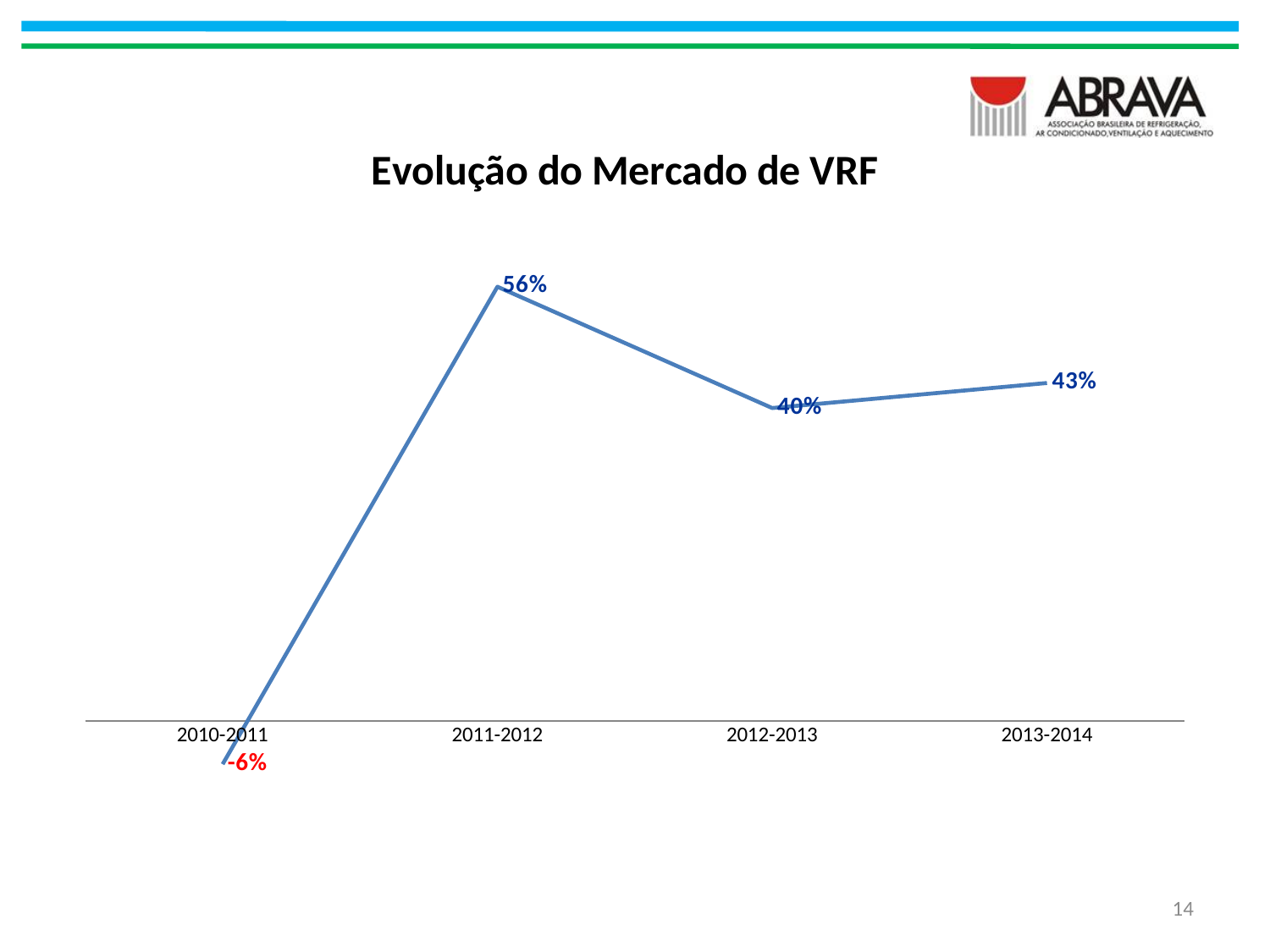
Which period has the highest value? 2011-2012 What is the difference between the values for 2011-2012 and 2012-2013? 16% Does the value rise or fall from 2010-2011 to 2011-2012? rise What is the value for 2013-2014? 43% Which period has the lowest value? 2010-2011 What kind of chart is shown? line chart What is the value for 2012-2013? 40% How many periods are plotted on the x axis? 4 What is the value for 2010-2011? -6% What is the value for 2011-2012? 56% Which is larger, the value for 2012-2013 or the value for 2013-2014? 2013-2014 What is the title of the chart? Evolução do Mercado de VRF